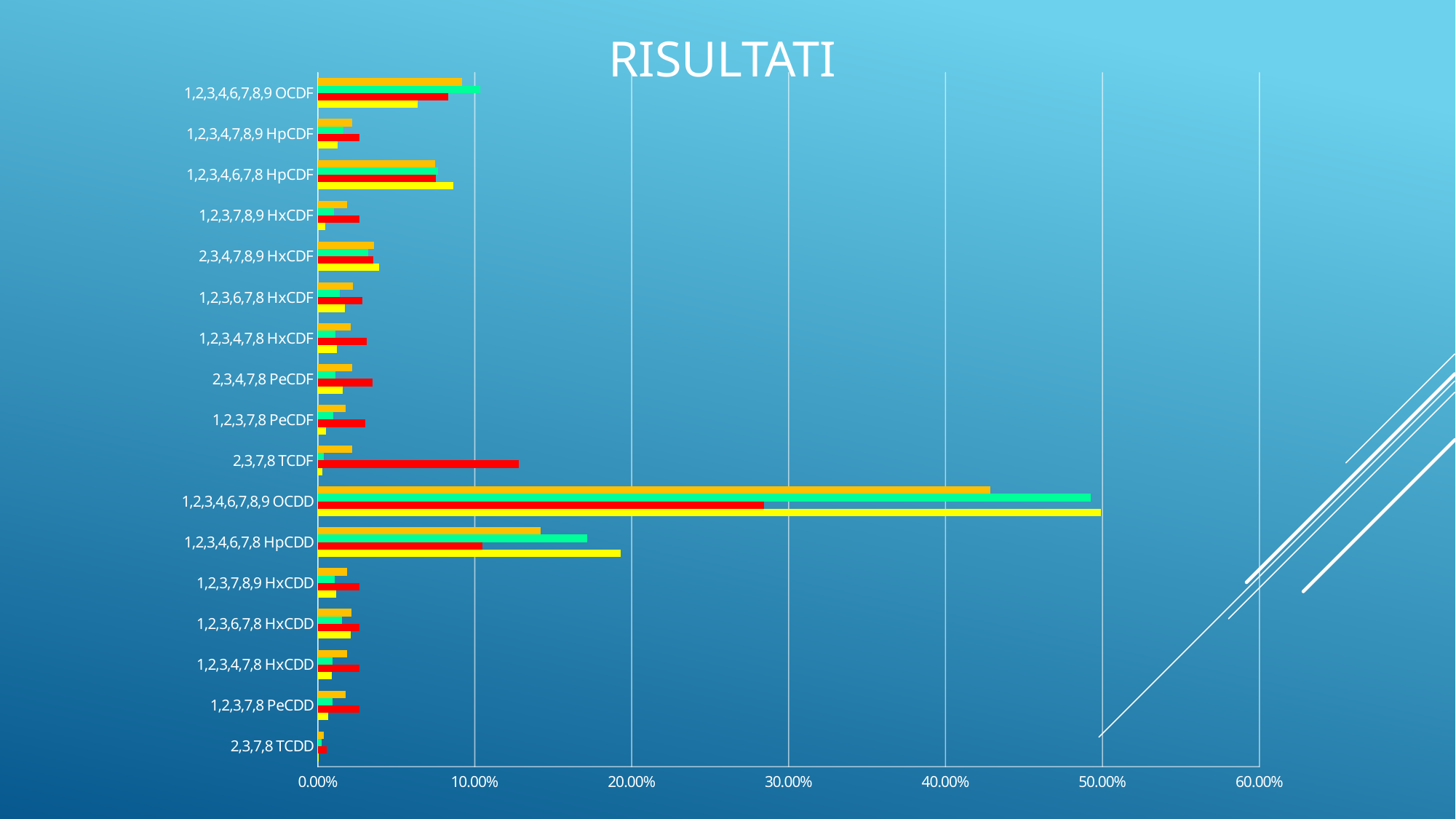
How many bars are plotted for each category in the chart? 4 Is the value of the red bar for 1,2,3,4,6,7,8,9 OCDD greater or less than 30.00%? less Is the value of the yellow bar for 1,2,3,4,6,7,8 HpCDD greater or less than 20.00%? less What kind of chart is shown on the slide? bar chart Is the value of the orange bar for 1,2,3,4,6,7,8,9 OCDD greater or less than 40.00%? greater How many categories are listed on the vertical axis of the chart? 17 Which category has the shortest bars in the chart? 2,3,7,8 TCDD Which has the larger red bar, 2,3,7,8 TCDF or 2,3,7,8 TCDD? 2,3,7,8 TCDF Which category has larger values, 1,2,3,4,6,7,8,9 OCDD or 1,2,3,4,6,7,8 HpCDD? 1,2,3,4,6,7,8,9 OCDD What is the title of the chart? RISULTATI Which category has the longest bar in the chart? 1,2,3,4,6,7,8,9 OCDD